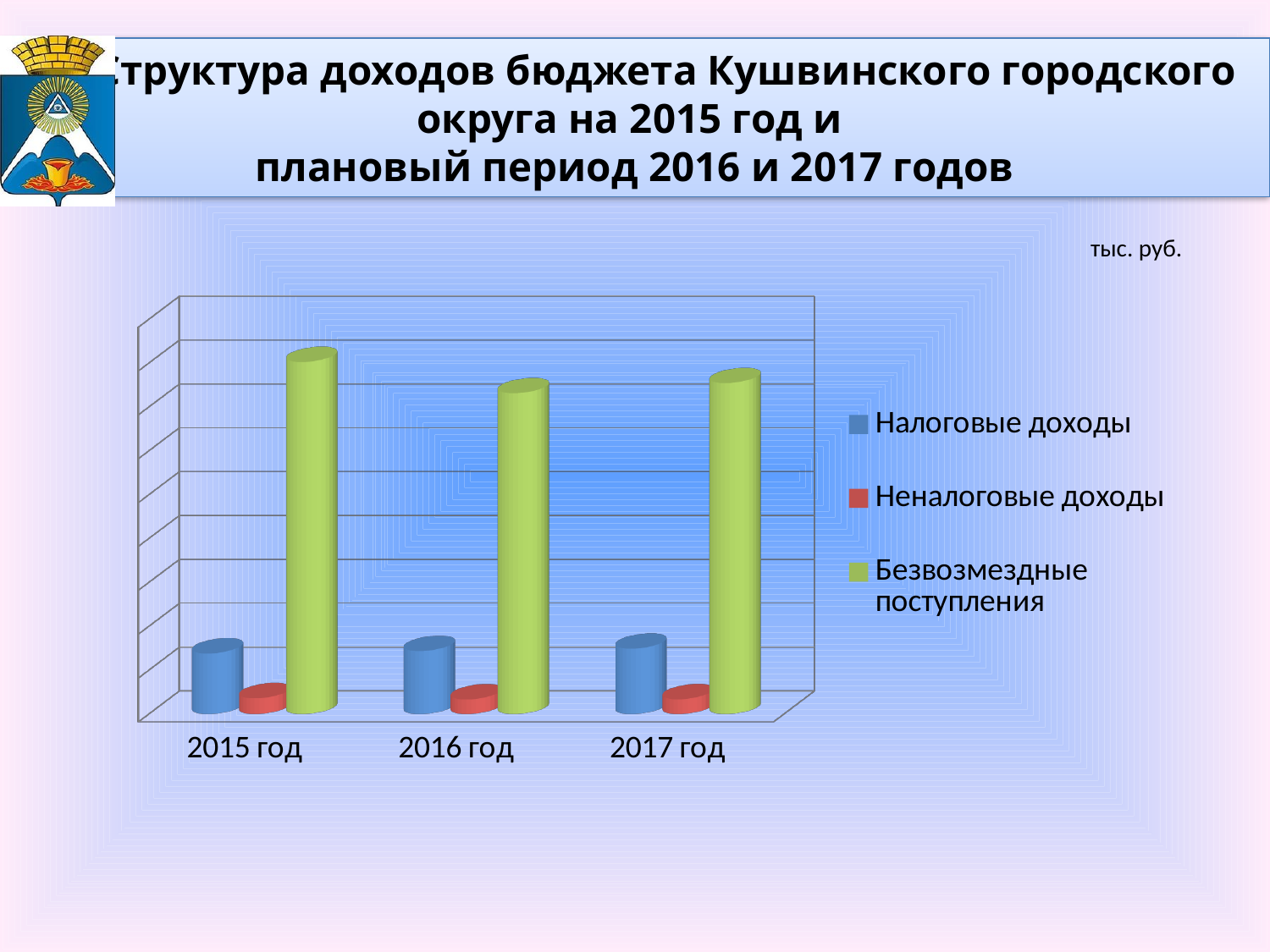
For 2017 год, which is larger: Безвозмездные поступления or Налоговые доходы? Безвозмездные поступления For Безвозмездные поступления, which year has the larger value: 2015 год or 2016 год? 2015 год How many year categories are shown on the x axis of the chart? 3 For 2016 год, which is larger: Налоговые доходы or Неналоговые доходы? Налоговые доходы How many series does the chart legend list? 3 Which series has the highest value for 2015 год? Безвозмездные поступления What kind of chart is shown on the slide? Bar chart Which series has the highest value for 2017 год? Безвозмездные поступления Which series has the lowest value for 2015 год? Неналоговые доходы What unit of measurement is indicated for the chart? тыс. руб. What colour represents Безвозмездные поступления in the chart? Green Which series has the lowest value for 2016 год? Неналоговые доходы